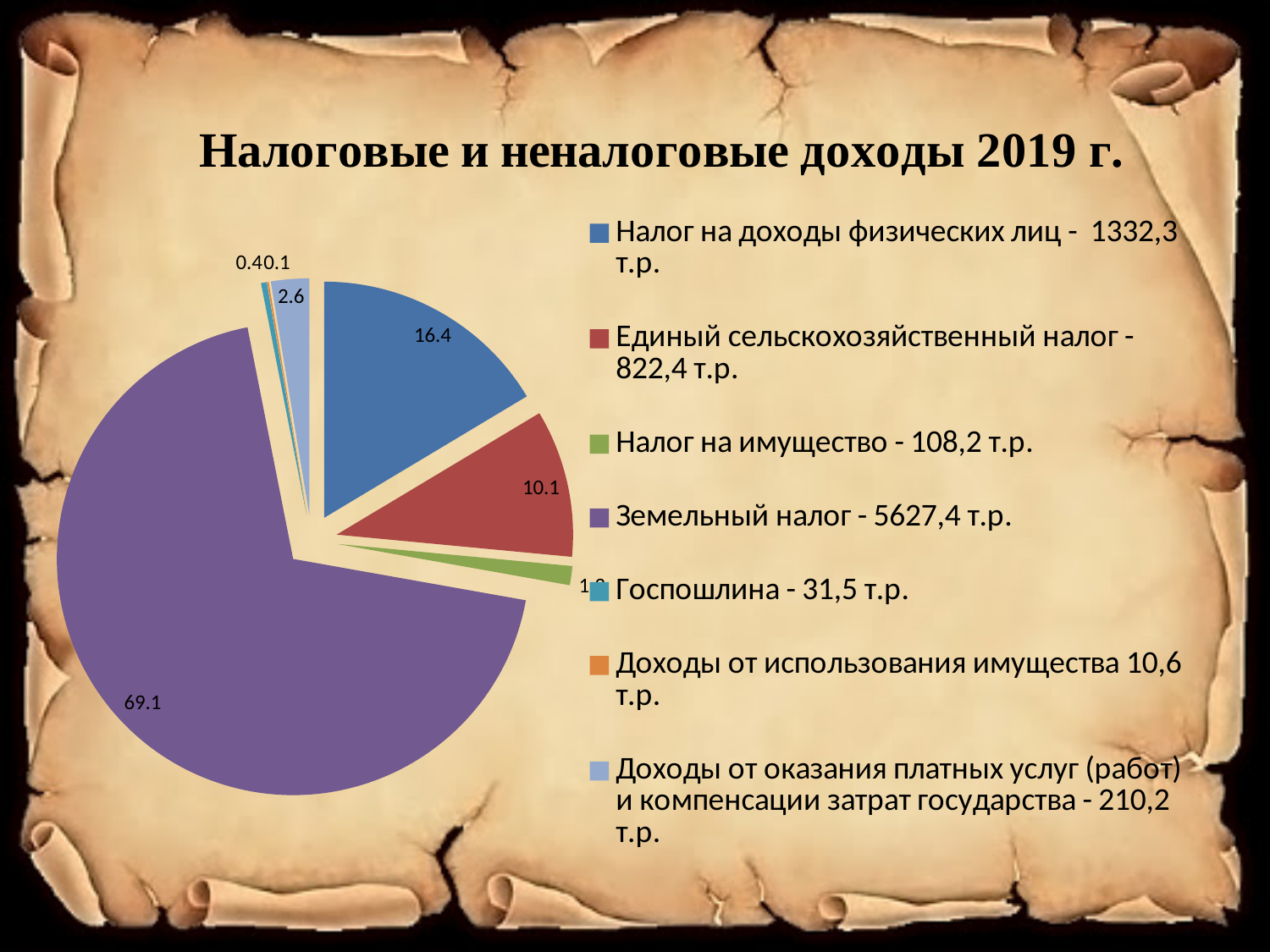
What is the difference between the labels for Земельный налог and Налог на доходы физических лиц? 52.7 What percentage label is shown on the slice for Налог на доходы физических лиц? 16.4 What is the title of the chart? Налоговые и неналоговые доходы 2019 г. What percentage label is shown on the slice for Земельный налог? 69.1 How many slices does the pie chart have? 7 What percentage label is shown on the slice for Единый сельскохозяйственный налог? 10.1 How many entries does the legend list? 7 What type of chart is shown on the slide? pie chart According to the legend, what is the amount for Госпошлина? 31,5 т.р. Which slice is larger: Единый сельскохозяйственный налог or Доходы от оказания платных услуг (работ) и компенсации затрат государства? Единый сельскохозяйственный налог Which category has the largest slice of the pie? Земельный налог Which category has the smallest slice of the pie? Доходы от использования имущества